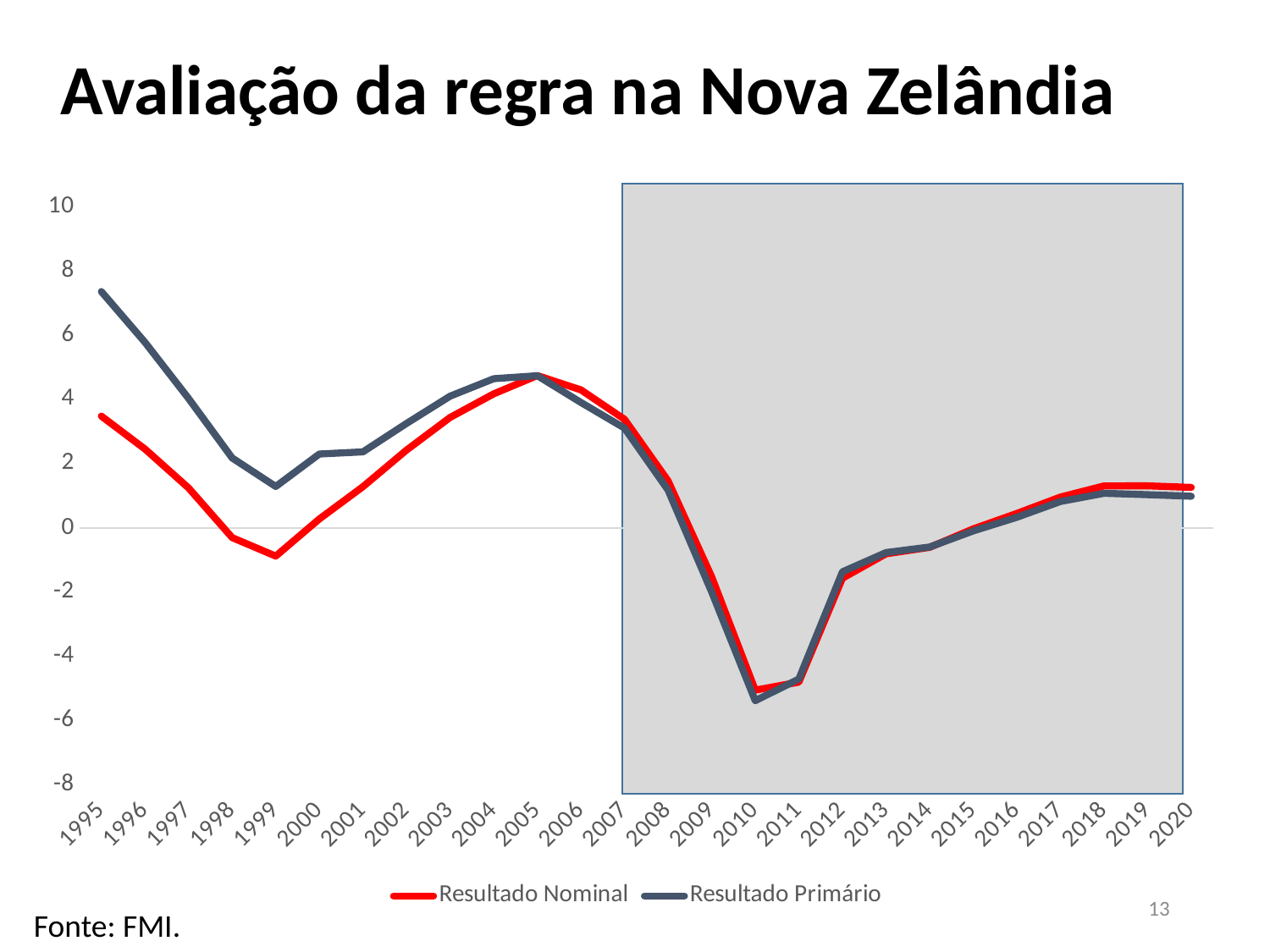
What source is cited below the chart? FMI Is the value for Resultado Primário in 2010 greater or less than -4? less How many series does the legend list? 2 Is the value for Resultado Primário in 1995 greater or less than 6? greater Is the value for Resultado Nominal in 2005 greater or less than 4? greater How many years are plotted along the x axis? 26 In which year does Resultado Primário reach its highest value? 1995 What are the two series named in the legend? Resultado Nominal and Resultado Primário In 1995, which series has the higher value, Resultado Nominal or Resultado Primário? Resultado Primário In which year does Resultado Primário reach its lowest value? 2010 What kind of chart is shown on the slide? line chart